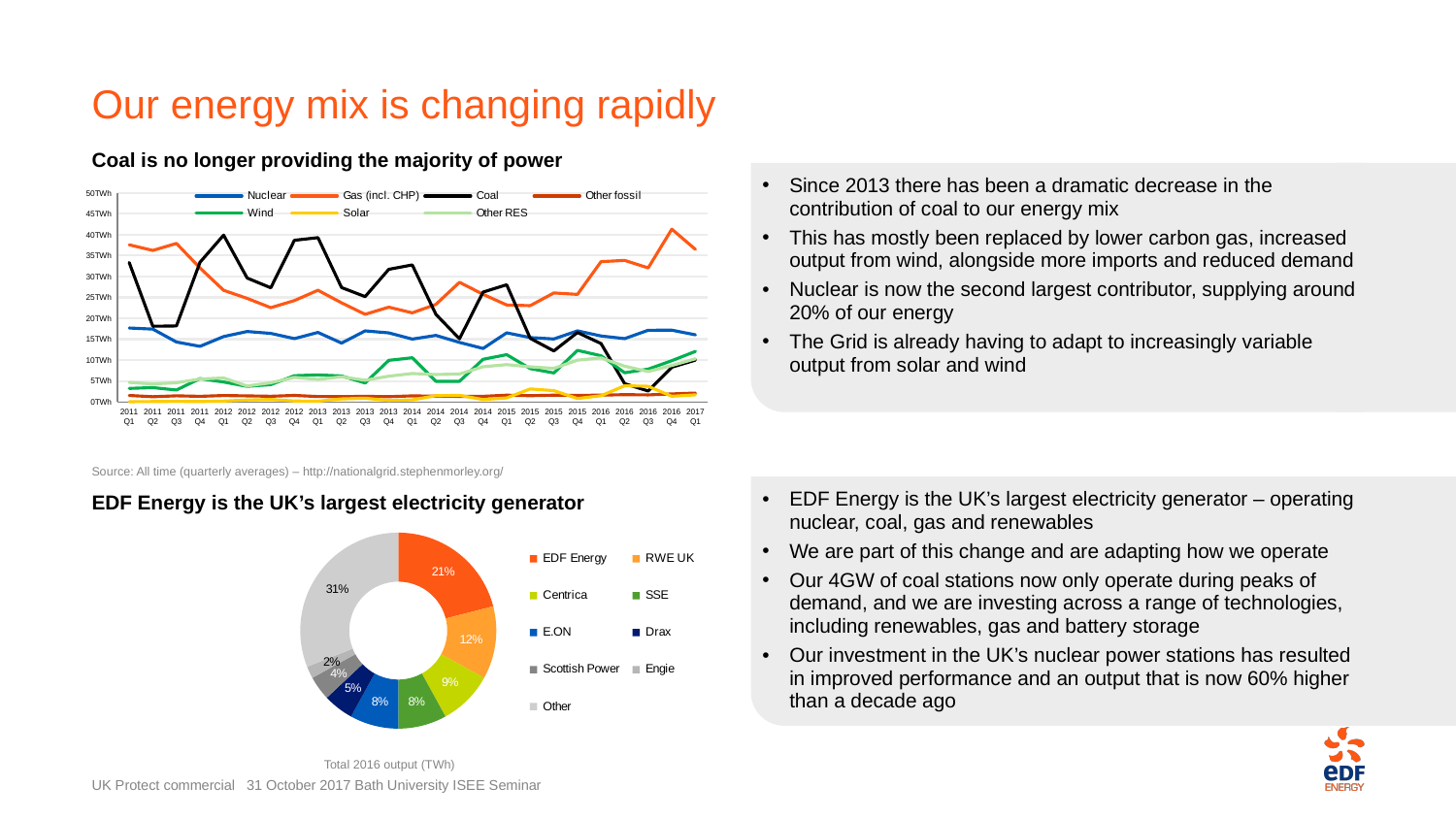
How many series does the legend of the line chart 'Coal is no longer providing the majority of power' list? 7 What kind of chart is the chart titled 'Coal is no longer providing the majority of power'? Line chart In the doughnut chart at the bottom of the slide, what share is shown for RWE UK? 12% In the line chart 'Coal is no longer providing the majority of power', is the value for Coal in 2017 Q1 greater or less than 15TWh? less In the line chart 'Coal is no longer providing the majority of power', does the Coal series generally rise or fall from 2011 Q1 to 2017 Q1? Fall In the doughnut chart at the bottom of the slide, what is the difference in percentage points between the EDF Energy share and the Centrica share? 12 In the line chart 'Coal is no longer providing the majority of power', is the value for Coal in 2011 Q1 greater or less than 30TWh? greater In the doughnut chart at the bottom of the slide, which is larger: the share for Drax or the share for Scottish Power? Drax In the line chart 'Coal is no longer providing the majority of power', which series is higher in 2017 Q1: Gas (incl. CHP) or Coal? Gas (incl. CHP) How many slices does the doughnut chart at the bottom of the slide have? 9 In the doughnut chart titled 'EDF Energy is the UK's largest electricity generator', what share of total 2016 output is attributed to EDF Energy? 21% In the doughnut chart at the bottom of the slide, which named generator (excluding 'Other') has the smallest share? Engie